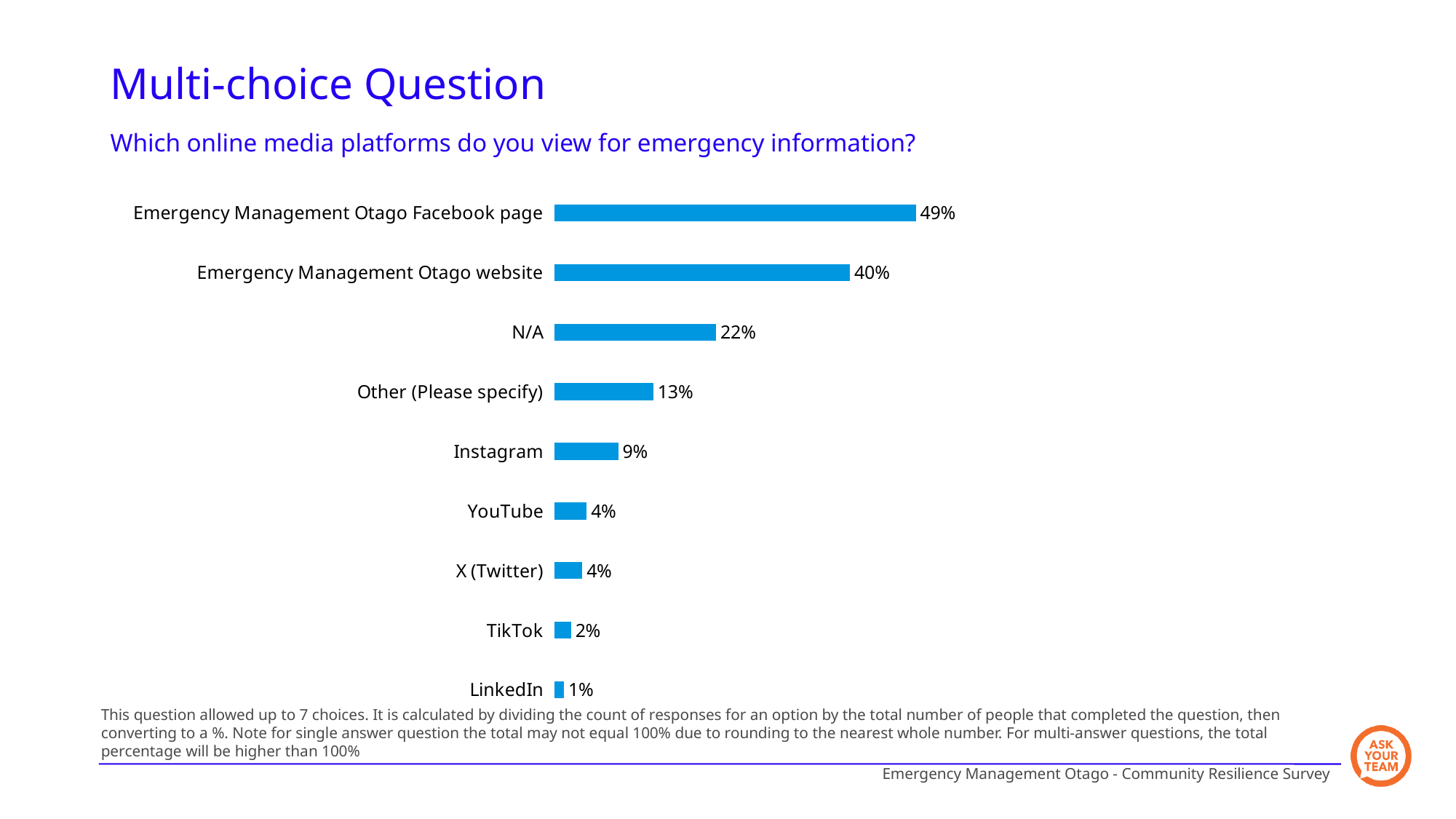
What type of chart is shown on the slide? Bar chart How many categories are shown in the chart? 9 What is the difference between the Emergency Management Otago Facebook page and the Emergency Management Otago website percentages? 9% Which is larger, the value for Instagram or the value for TikTok? Instagram What percentage is shown for N/A? 22% What is the value shown for Instagram? 9% What question does the chart answer, according to the subtitle? Which online media platforms do you view for emergency information? What value is shown for both YouTube and X (Twitter)? 4% Which platform has the lowest percentage? LinkedIn What is the difference between the N/A and Other (Please specify) values? 9% What percentage of respondents view the Emergency Management Otago Facebook page for emergency information? 49% Which platform has the highest percentage? Emergency Management Otago Facebook page